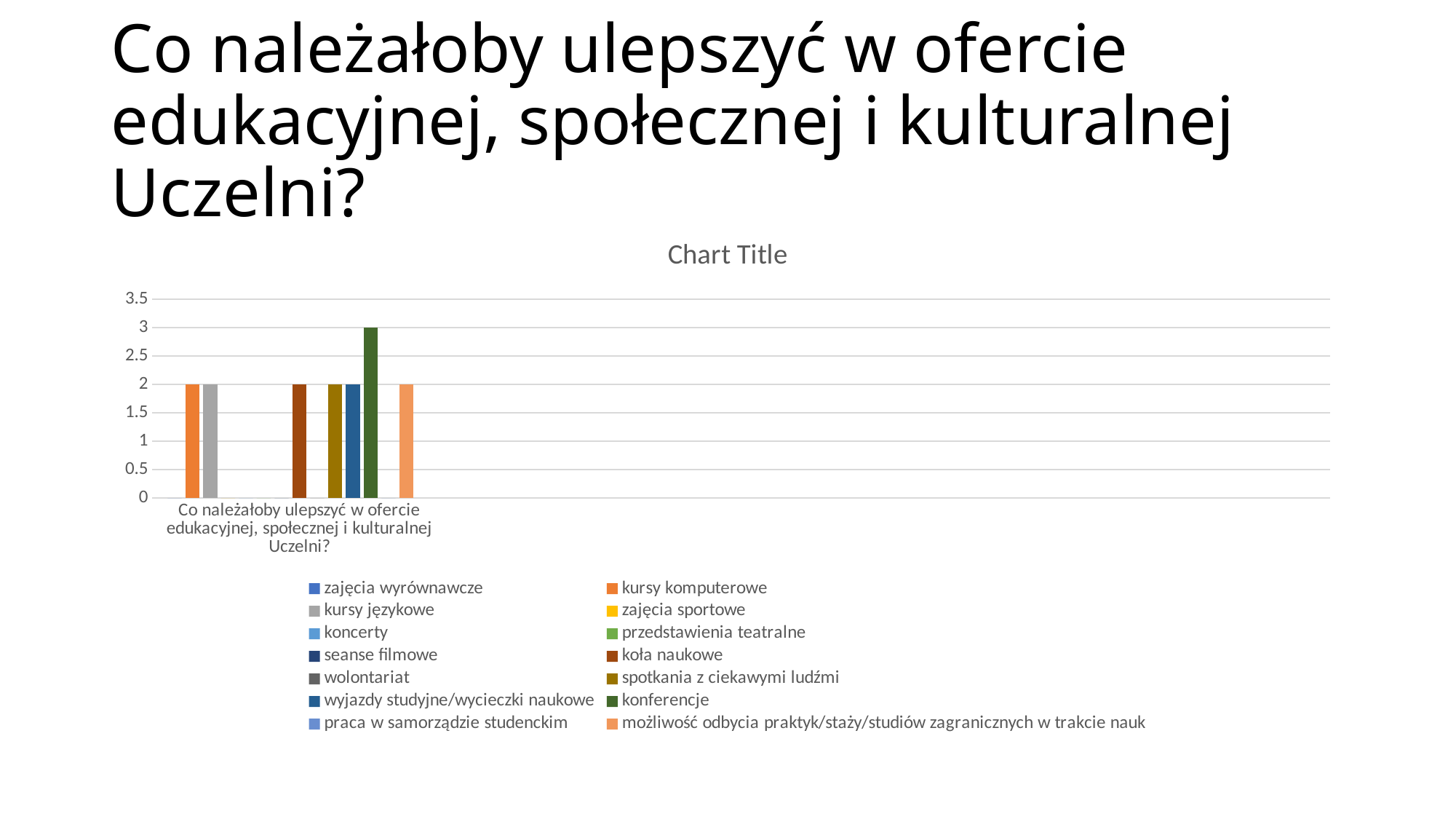
Which series has the highest bar in the chart? konferencje Which is larger, the value for konferencje or the value for koła naukowe? konferencje Is the value for konferencje greater or less than 2.5? greater What is the value of the bar for kursy komputerowe? 2 What is the value of the bar for konferencje? 3 What is the title shown above the chart? Chart Title How many series does the chart legend list? 14 What is the value of the bar for wyjazdy studyjne/wycieczki naukowe? 2 What is the highest value shown on the vertical axis of the chart? 3.5 What is the difference between the value for konferencje and the value for kursy językowe? 1 How many categories are shown on the x axis of the chart? 1 What kind of chart is shown on the slide? bar chart